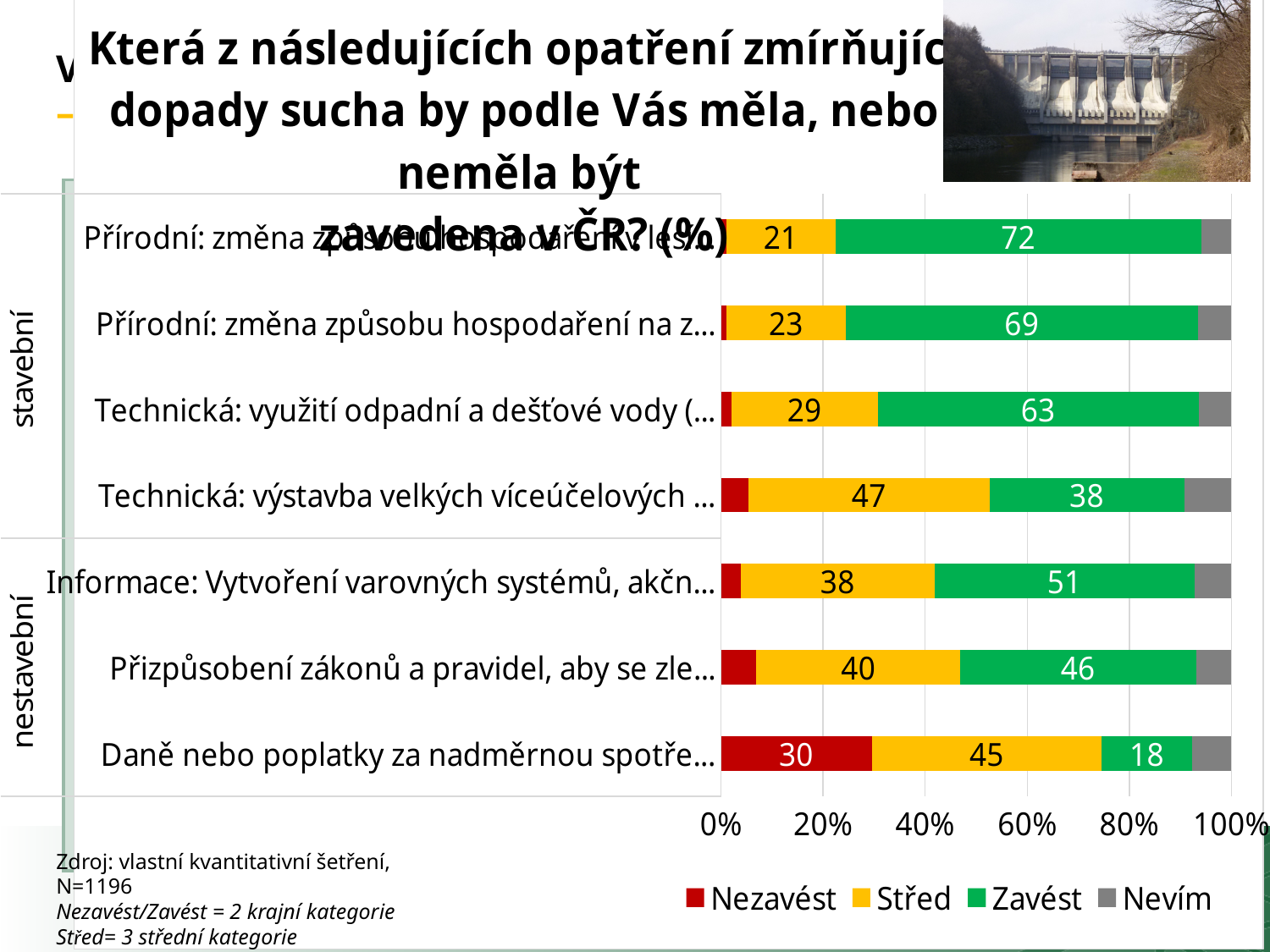
What kind of chart is shown on the slide? Stacked bar chart What is the Zavést value for "Přírodní: změna způsobu hospodaření na z…"? 69 What is the Střed value for "Technická: výstavba velkých víceúčelových …"? 47 How many categories (bars) does the chart show? 7 What is the Zavést value for "Daně nebo poplatky za nadměrnou spotře…"? 18 How many series does the legend list? 4 Which has the larger Zavést value: "Informace: Vytvoření varovných systémů, akčn…" or "Přizpůsobení zákonů a pravidel, aby se zle…"? Informace: Vytvoření varovných systémů, akčn… Which category has the highest Střed value? Technická: výstavba velkých víceúčelových … What is the Nezavést value for "Daně nebo poplatky za nadměrnou spotře…"? 30 Which category has the lowest Zavést value? Daně nebo poplatky za nadměrnou spotře… For "Daně nebo poplatky za nadměrnou spotře…", what is the difference between the Střed value and the Zavést value? 27 Is the Nezavést value for "Technická: výstavba velkých víceúčelových …" greater or less than 20%? less